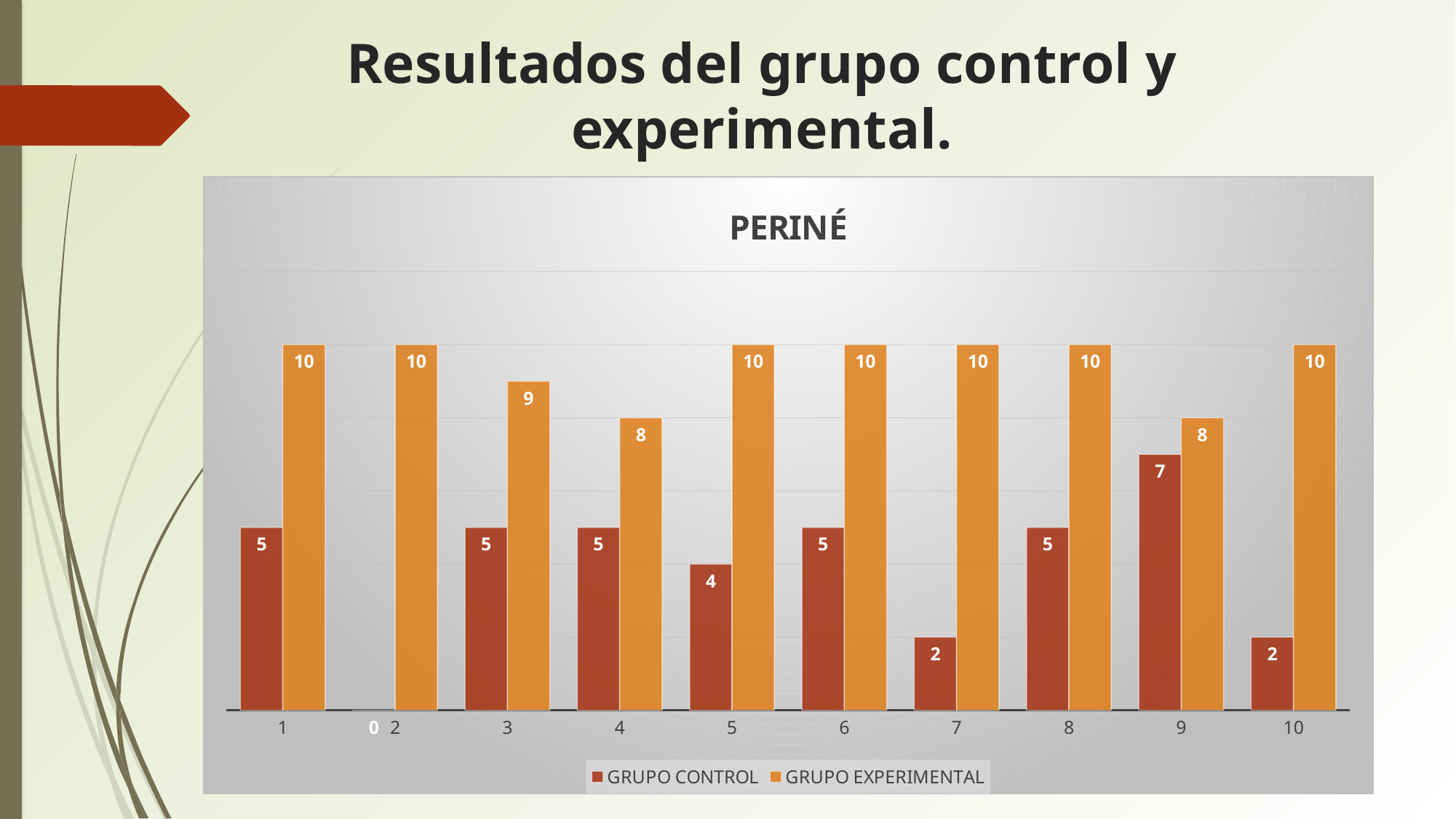
What kind of chart is shown? bar chart What is the title of the chart? PERINÉ How many categories are shown on the x axis? 10 Which category has the highest value for GRUPO CONTROL? 9 Which category has the lowest value for GRUPO CONTROL? 2 What is the value for GRUPO EXPERIMENTAL at category 3? 9 Which is larger at category 9, GRUPO CONTROL or GRUPO EXPERIMENTAL? GRUPO EXPERIMENTAL What is the difference between GRUPO EXPERIMENTAL and GRUPO CONTROL at category 7? 8 How many series does the legend list? 2 What is the value for GRUPO EXPERIMENTAL at category 4? 8 What is the value for GRUPO CONTROL at category 2? 0 What is the value for GRUPO CONTROL at category 9? 7